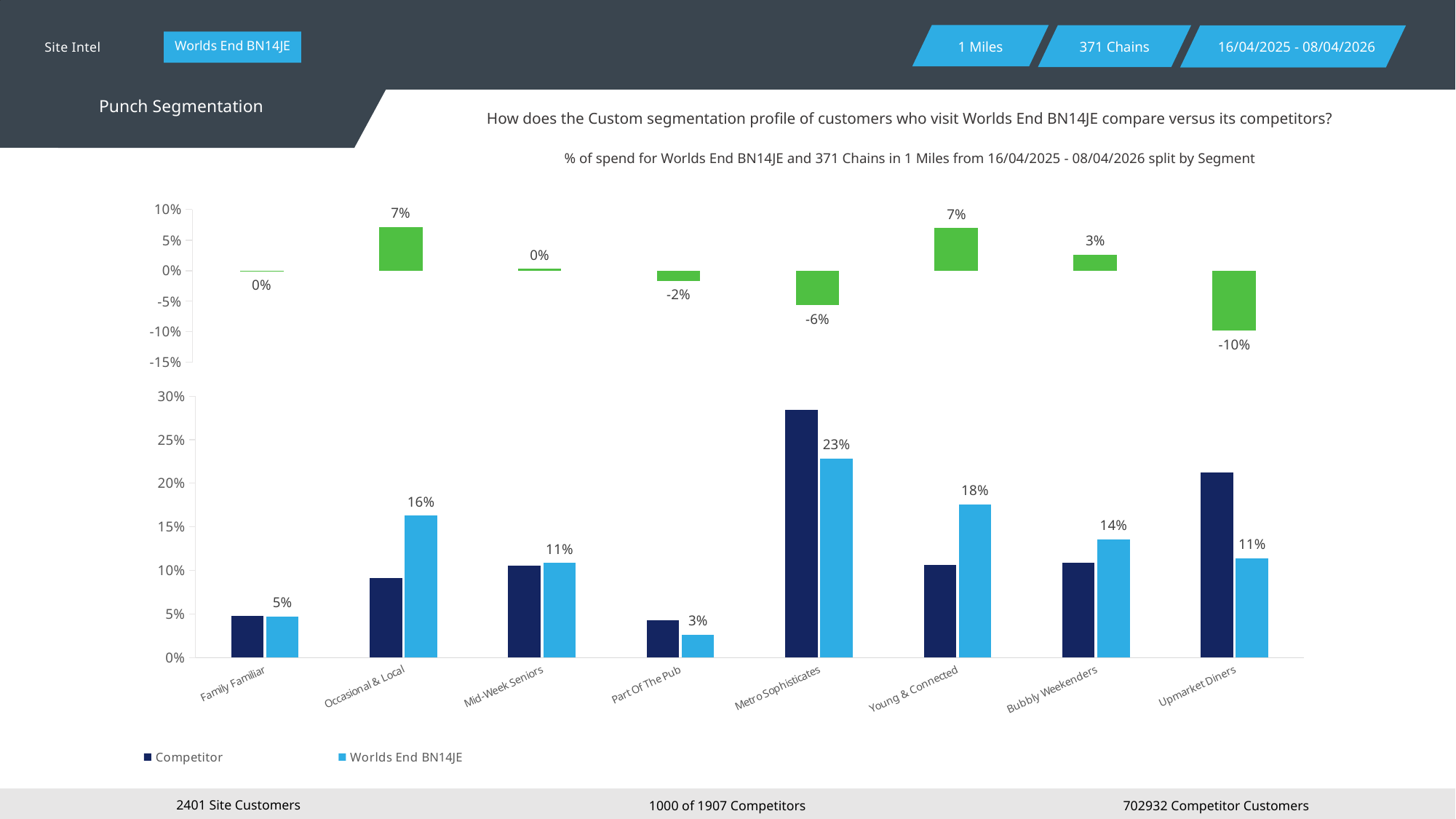
In the bottom chart, for Upmarket Diners, which is larger: the Competitor value or the Worlds End BN14JE value? Competitor In the bottom chart, is the Competitor value for Metro Sophisticates greater or less than 25%? greater In the bottom chart, is the Competitor value for Occasional & Local greater or less than 10%? less How many segments are shown on the x axis of the bottom chart? 8 In the bottom chart, which segment has the highest Worlds End BN14JE value? Metro Sophisticates What kind of chart is the bottom chart? Bar chart In the top chart, which segment has the lowest value? Upmarket Diners What are the two series named in the legend of the bottom chart? Competitor and Worlds End BN14JE In the bottom chart, what is the difference between the Worlds End BN14JE values for Young & Connected and Part Of The Pub? 15 percentage points How many series does the legend of the bottom chart list? 2 In the bottom chart, what is the Worlds End BN14JE value for Metro Sophisticates? 23% In the top chart, what is the value shown for Upmarket Diners? -10%